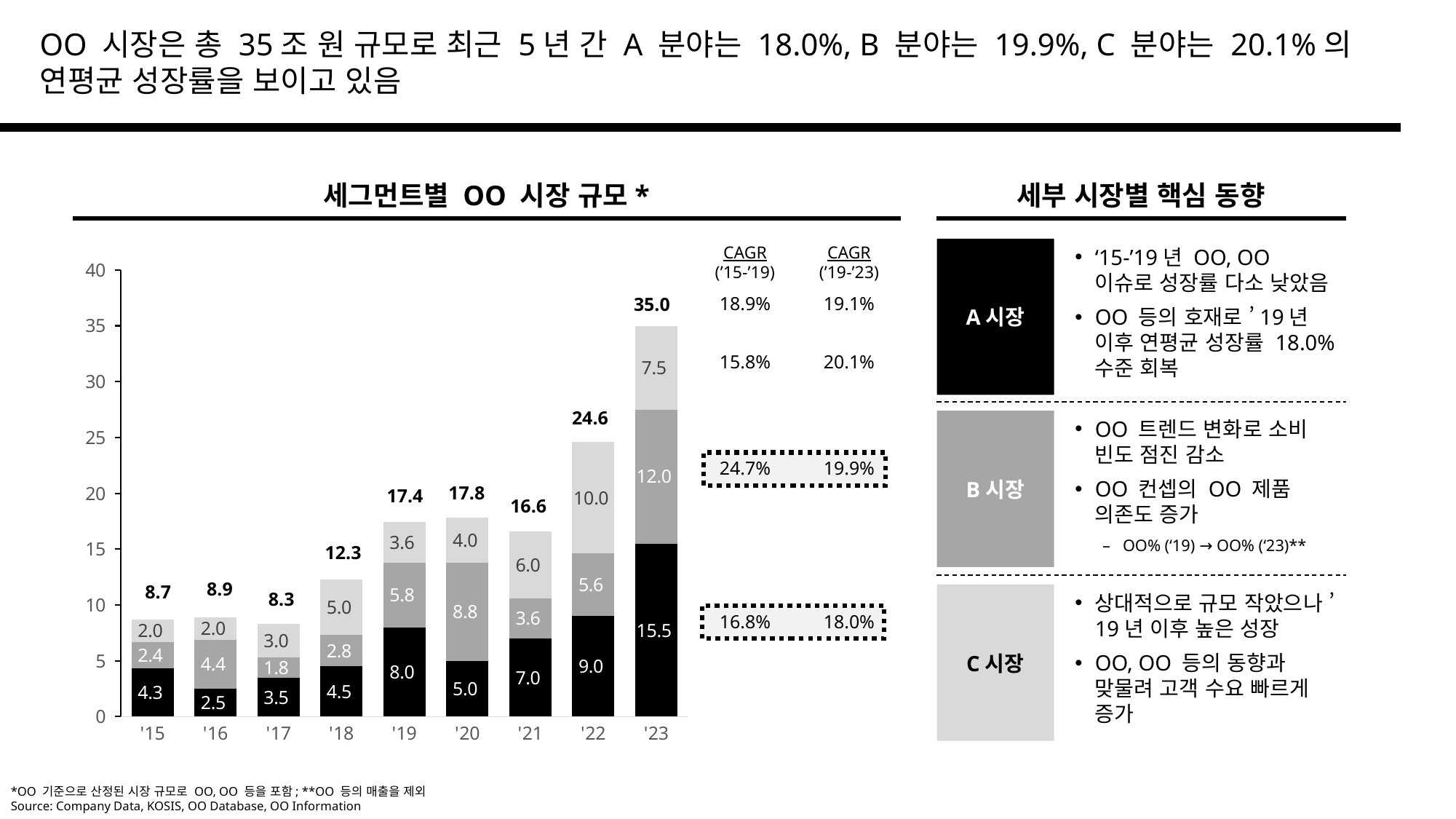
Which is larger, the total for '20 or the total for '21? '20 How many years are shown on the x axis of the chart? 9 What kind of chart is shown on the slide? Stacked bar chart What is the title of the chart on the left of the slide? 세그먼트별 OO 시장 규모 * What is the total value labeled above the '23 bar? 35.0 What is the value of the top (light gray) segment of the '22 bar? 10.0 Which year has the highest total bar value? '23 Is the total value for '18 greater or less than 10? greater What is the difference between the total values for '23 and '22? 10.4 Which year has the lowest total bar value? '17 What is the value of the bottom (black) segment of the '19 bar? 8.0 What is the value of the middle (dark gray) segment of the '20 bar? 8.8